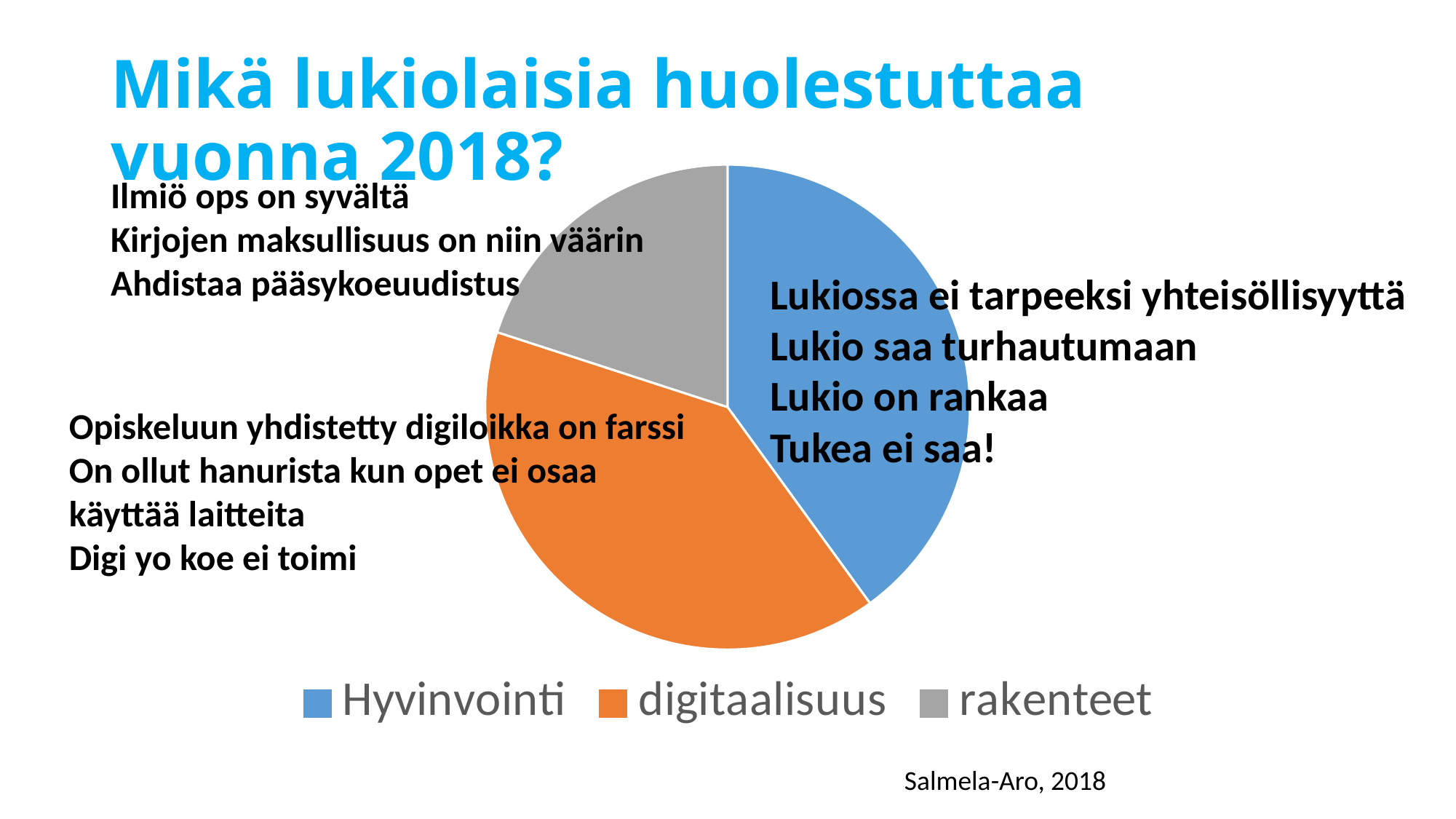
How many entries does the legend of the pie chart list? 3 How many slices does the pie chart have? 3 Which slice is larger in the pie chart, Hyvinvointi or rakenteet? Hyvinvointi Which category has the smallest slice in the pie chart? rakenteet Which category is shown in orange in the pie chart? digitaalisuus What colour is the Hyvinvointi slice in the pie chart? blue Which slice is larger in the pie chart, digitaalisuus or rakenteet? digitaalisuus What kind of chart is shown on the slide? pie chart